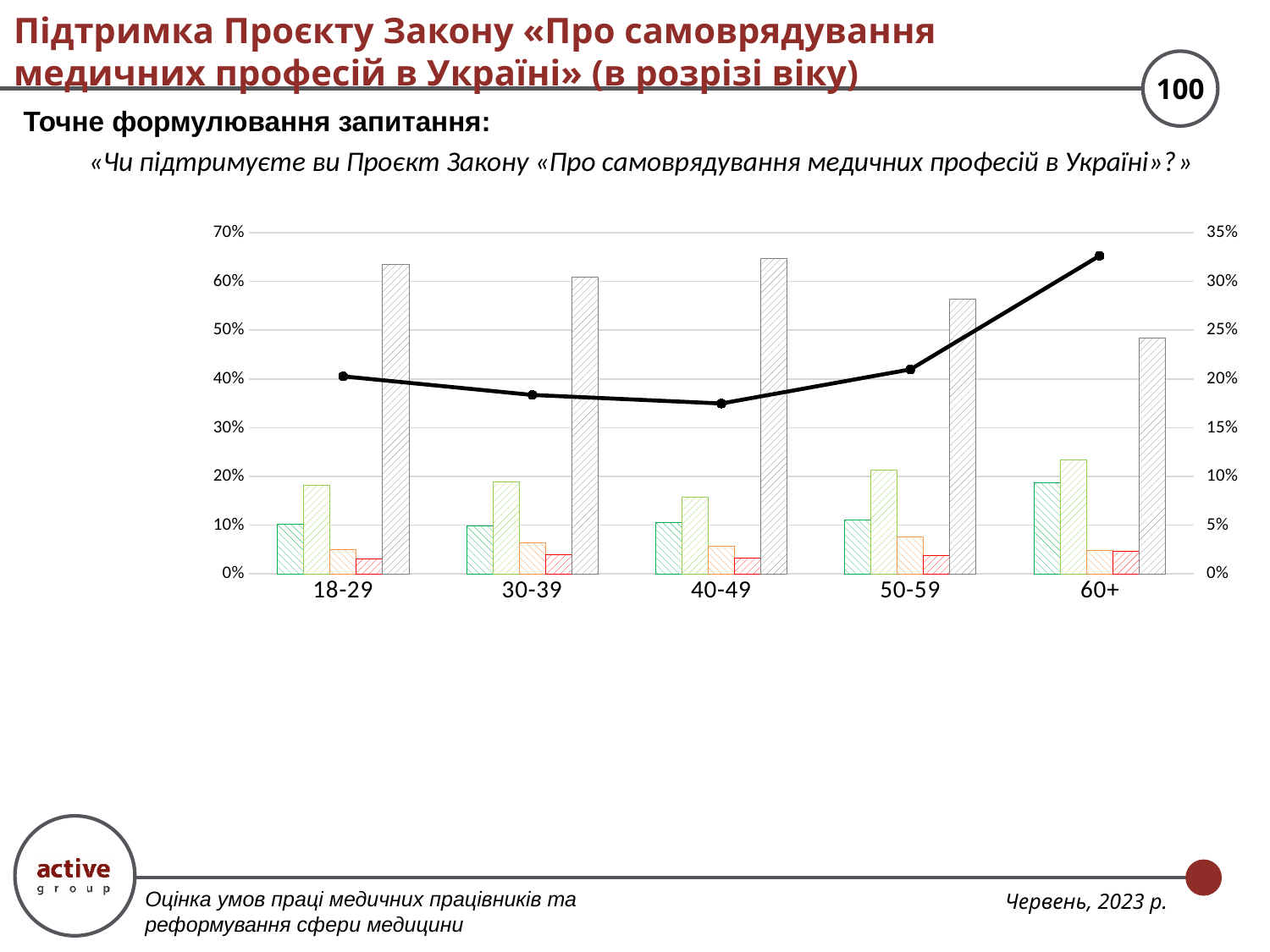
On the right-hand axis, is the black line value for 40-49 greater or less than 20%? less Does the black line rise or fall from 18-29 to 40-49? falls Which age category has the lowest tall grey hatched bar? 60+ Is the tall grey hatched bar for 50-59 greater or less than 50%? greater What kind of chart is shown on the slide? A combination bar and line chart Which age category has the highest point on the black line? 60+ Is the tall grey hatched bar for 18-29 or for 60+ larger? 18-29 On the right-hand axis, is the black line value for 60+ greater or less than 30%? greater What is the maximum value shown on the left-hand vertical axis? 70% Does the black line rise or fall from 40-49 to 60+? rises How many age categories are shown on the x axis? 5